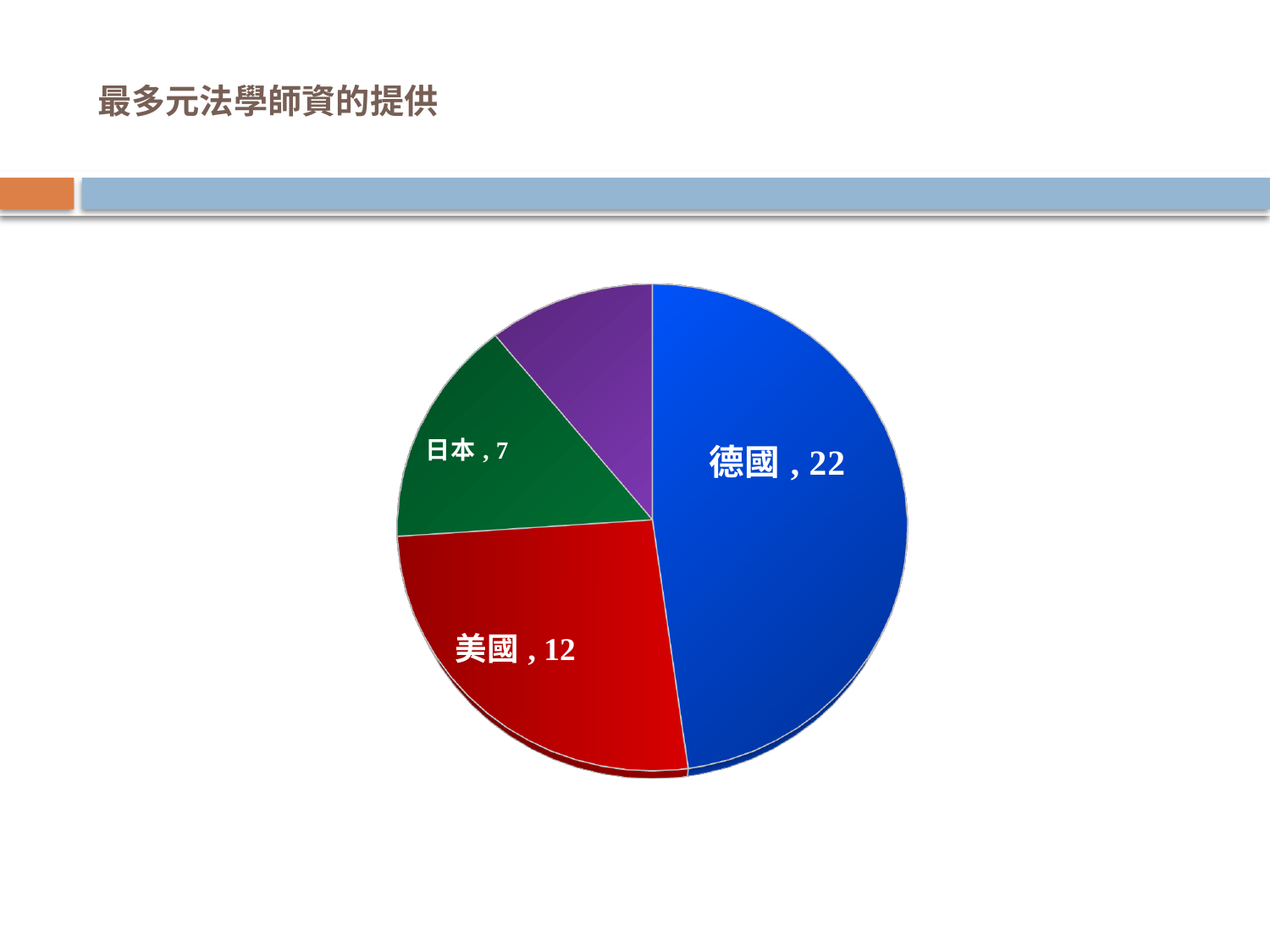
What is the difference between the values for 美國 and 日本? 5 How many slices does the pie chart have? 4 Which category has the largest slice in the pie chart? 德國 What is the title of the slide containing the chart? 最多元法學師資的提供 What value is shown for 美國 in the pie chart? 12 What colour is the slice for 德國? Blue What value is shown for 日本 in the pie chart? 7 Which is larger, the value for 美國 or the value for 日本? 美國 What kind of chart is shown on the slide? Pie chart What is the difference between the values for 德國 and 美國? 10 Which is larger, the value for 德國 or the value for 美國? 德國 What value is shown for 德國 in the pie chart? 22